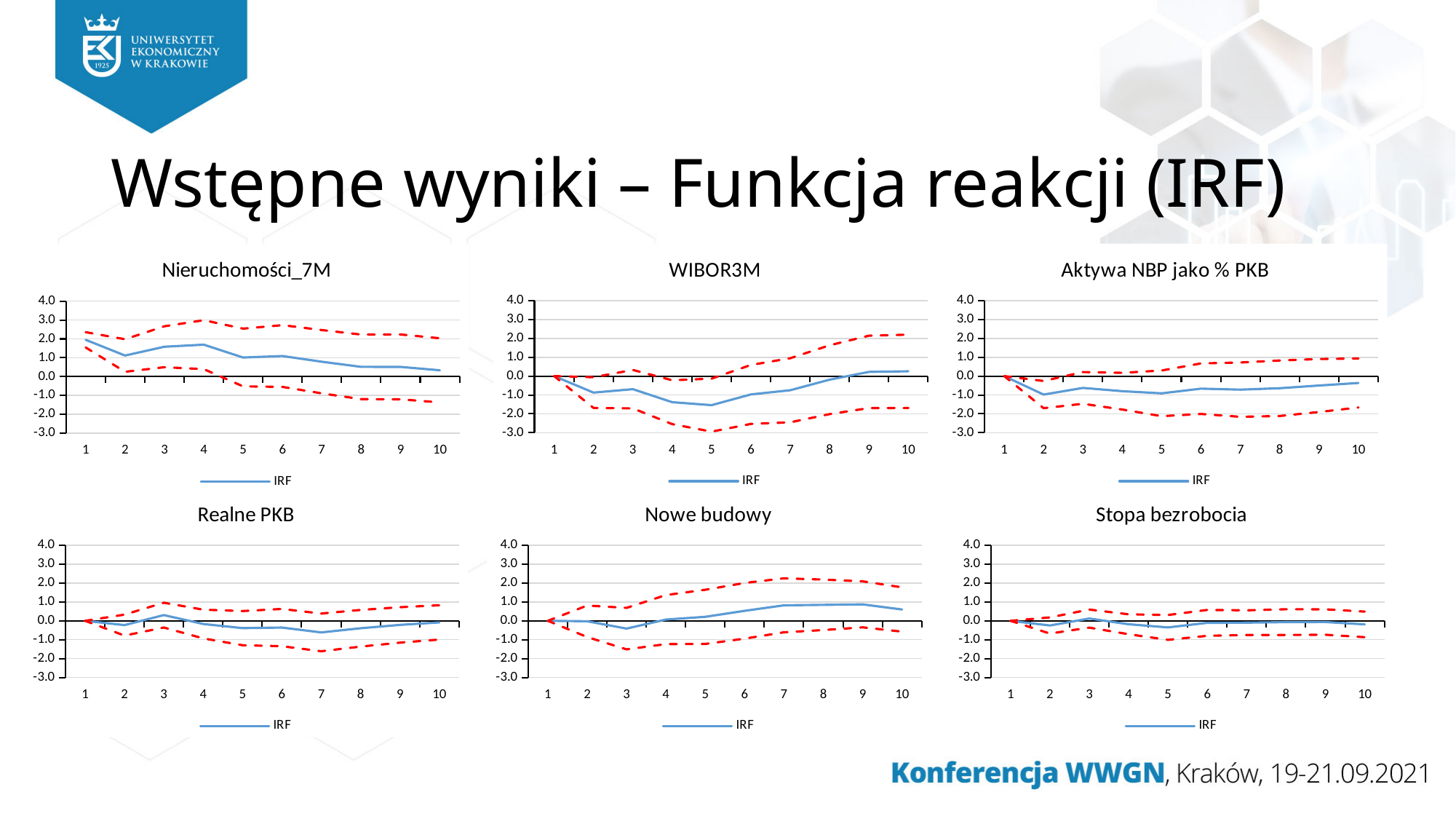
In the 'Nieruchomości_7M' chart, is the IRF value at point 1 greater or less than 1.0? greater How many points are shown on the x axis of the 'WIBOR3M' chart? 10 In the 'Nieruchomości_7M' chart, does the IRF line rise or fall from point 4 to point 10? fall In the 'WIBOR3M' chart, is the IRF value at point 5 greater or less than -1.0? less In the 'Nieruchomości_7M' chart, at which x-axis point is the IRF line highest? 1 What kind of chart is the 'Nieruchomości_7M' chart? line chart In the 'Aktywa NBP jako % PKB' chart, is the IRF value at point 2 greater or less than 0.0? less How many series does the legend of the 'Realne PKB' chart list? 1 In the 'Nowe budowy' chart, does the IRF line rise or fall from point 3 to point 9? rise In the 'WIBOR3M' chart, at which x-axis point is the IRF line lowest? 5 What is the title of the bottom-right chart on the slide? Stopa bezrobocia In the 'Nieruchomości_7M' chart, is the IRF value larger at point 1 or at point 10? point 1